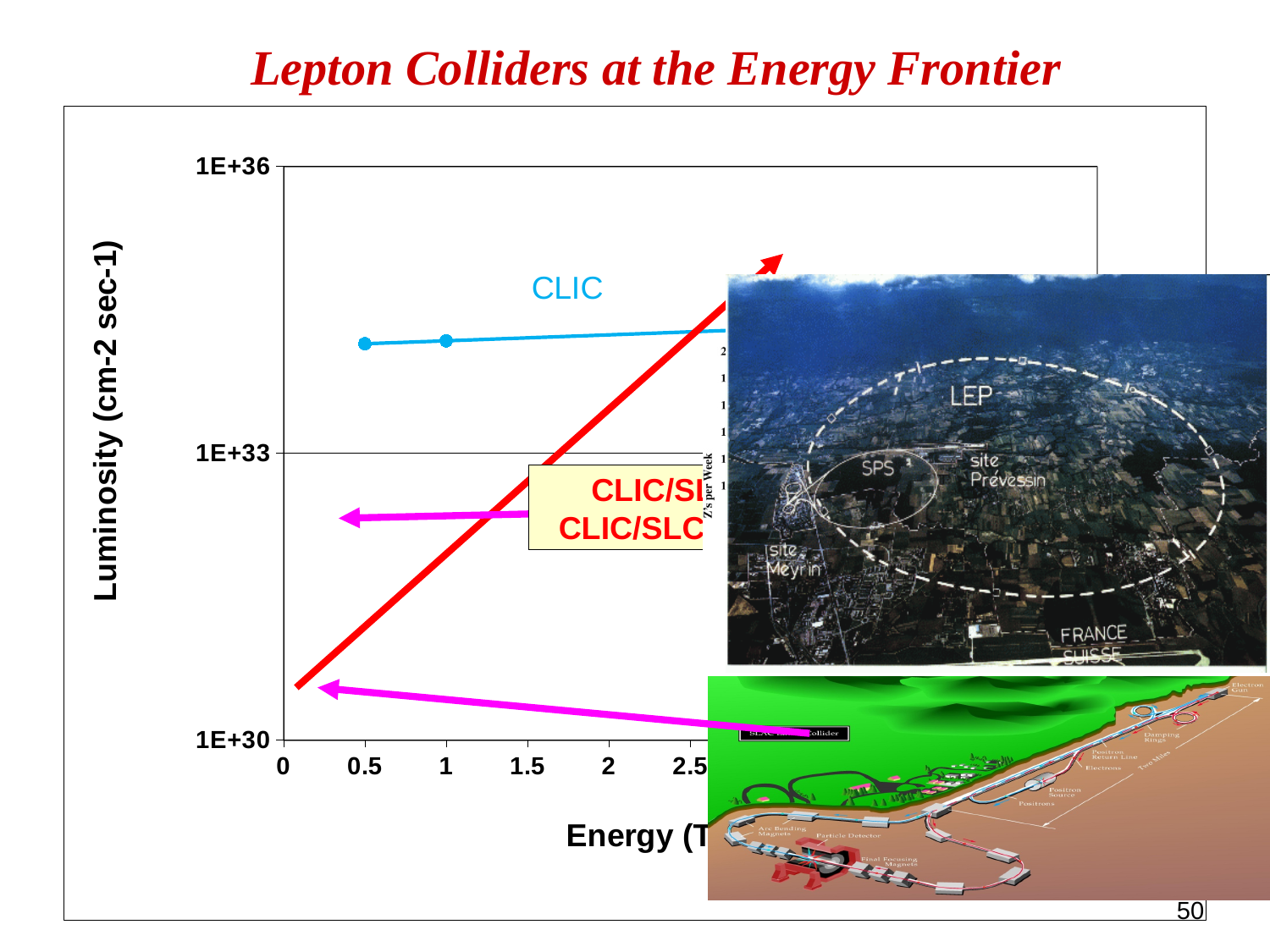
Does the red line rise or fall as energy increases? rises What is the label of the vertical axis of the chart? Luminosity (cm-2 sec-1) At an energy of 0.5, which is higher: the CLIC line or the red line? CLIC line Is the value of the red line at an energy of 0.5 greater or less than 1E+33? less Is the CLIC luminosity at an energy of 0.5 greater or less than 1E+33? greater What is the lowest tick value shown on the luminosity axis? 1E+30 Is the CLIC luminosity at an energy of 1 greater or less than 1E+36? less What is the highest tick value shown on the luminosity axis? 1E+36 Which series is labelled in blue text on the chart? CLIC What kind of chart is shown on the slide? line chart How many tick labels are shown on the luminosity axis? 3